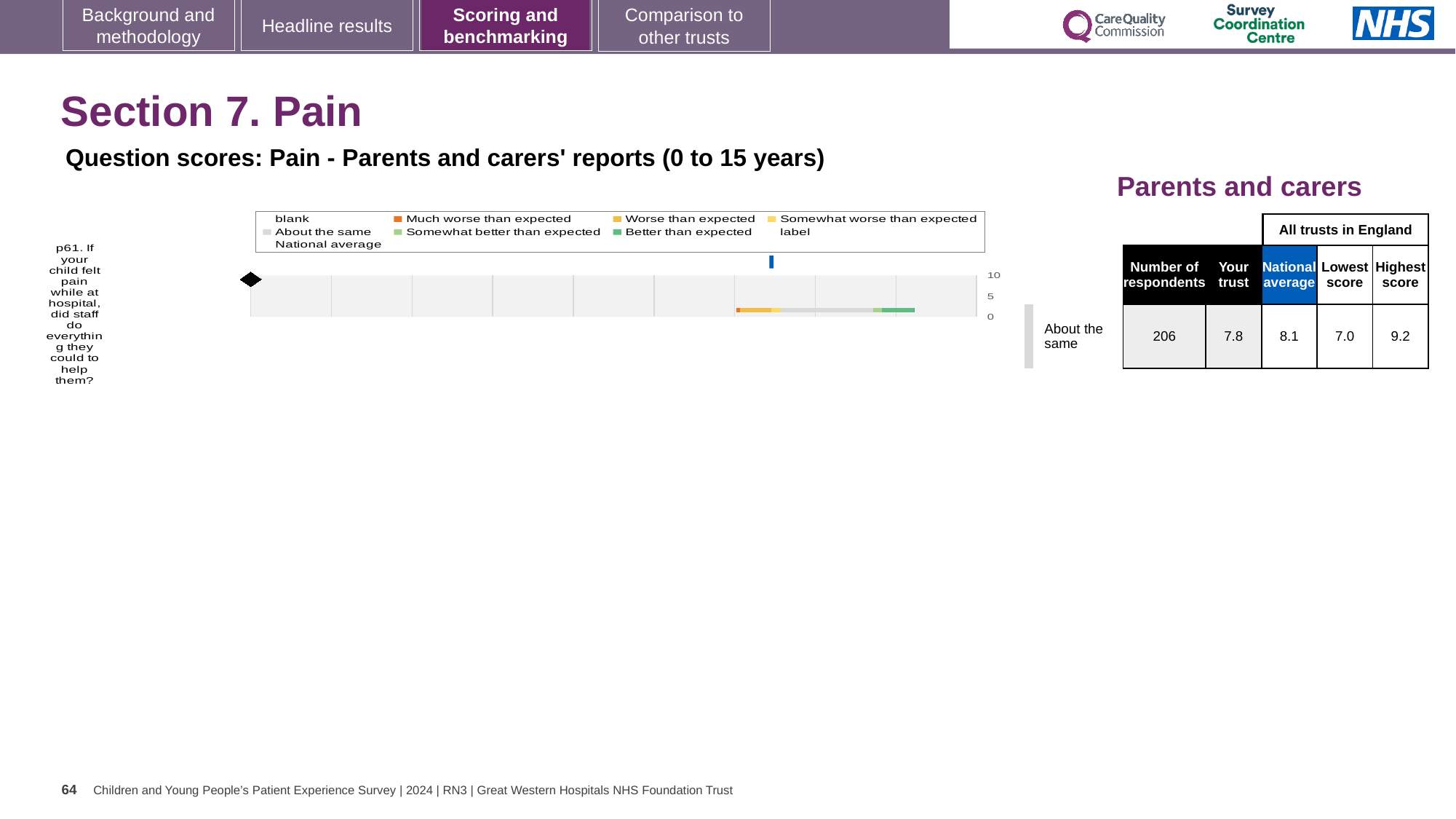
What kind of chart is shown on the slide? bar chart In the table next to the chart, what is the 'Your trust' score for p61? 7.8 What colour does the legend use for 'Better than expected'? green In the table next to the chart, what is the difference between the highest score and the lowest score for p61? 2.2 In the table next to the chart, what is the difference between the national average and the 'Your trust' score for p61? 0.3 How many survey questions are plotted in the chart? 1 Which survey question is plotted in the chart? p61. If your child felt pain while at hospital, did staff do everything they could to help them? In the table next to the chart, which is larger for p61: the 'Your trust' score or the national average? National average How many entries does the chart legend list? 9 In the table next to the chart, what is the national average score for p61? 8.1 In the table next to the chart, what is the number of respondents for p61? 206 In the table next to the chart, what is the highest score among all trusts in England for p61? 9.2